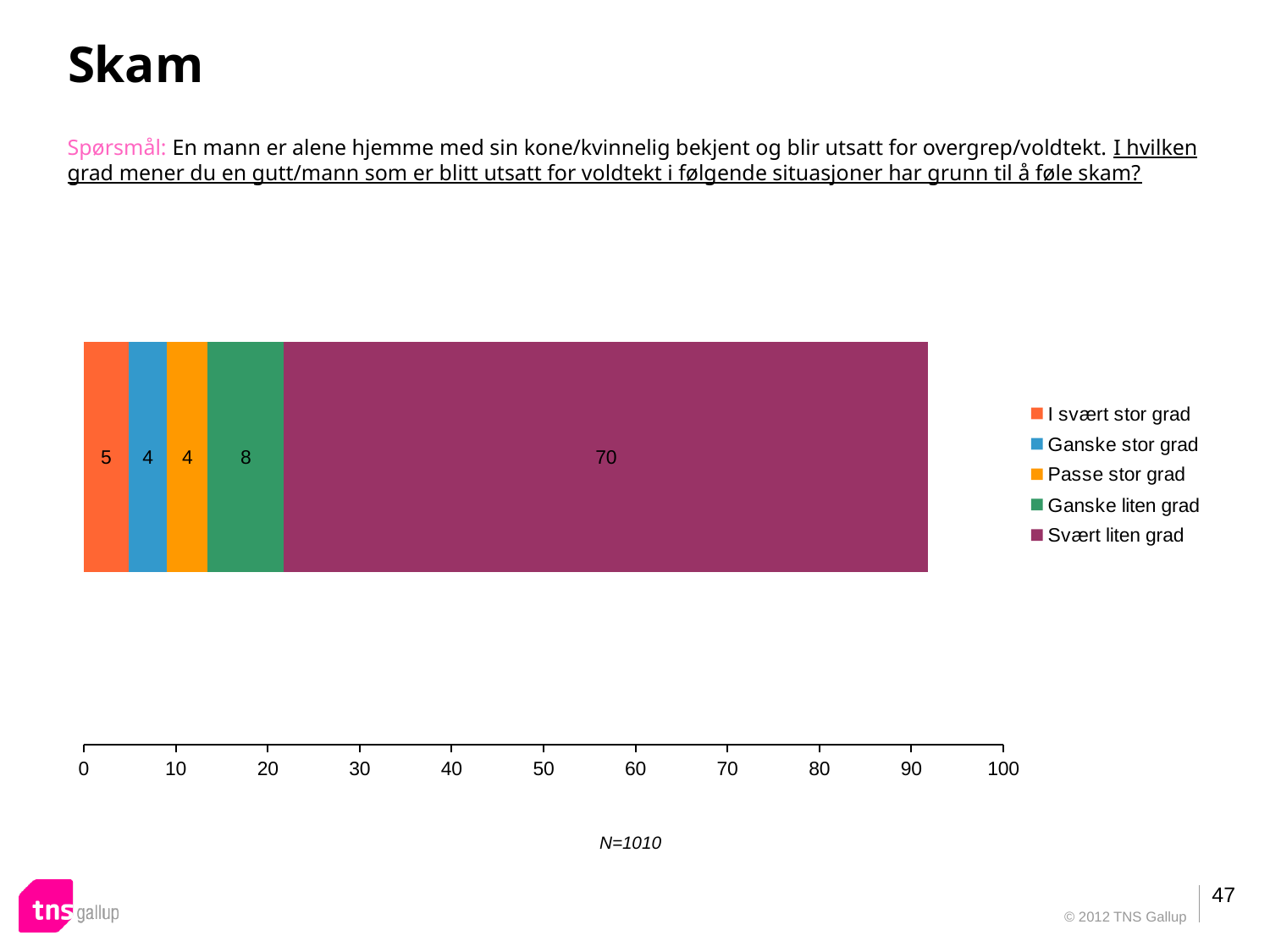
What value is shown for "Ganske liten grad"? 8 What colour is the segment for "Svært liten grad"? Purple Which is larger, the value for "Ganske liten grad" or the value for "I svært stor grad"? Ganske liten grad What value is shown for "Svært liten grad"? 70 What kind of chart is shown on the slide? Stacked bar chart What value is shown for "Passe stor grad"? 4 What is the difference between the values for "Svært liten grad" and "Ganske liten grad"? 62 Which series has the largest value in the bar? Svært liten grad How many series does the legend list? 5 What is the total of all the segments in the stacked bar? 91 What value is shown for "I svært stor grad"? 5 Is the value for "Svært liten grad" greater or less than 60? greater